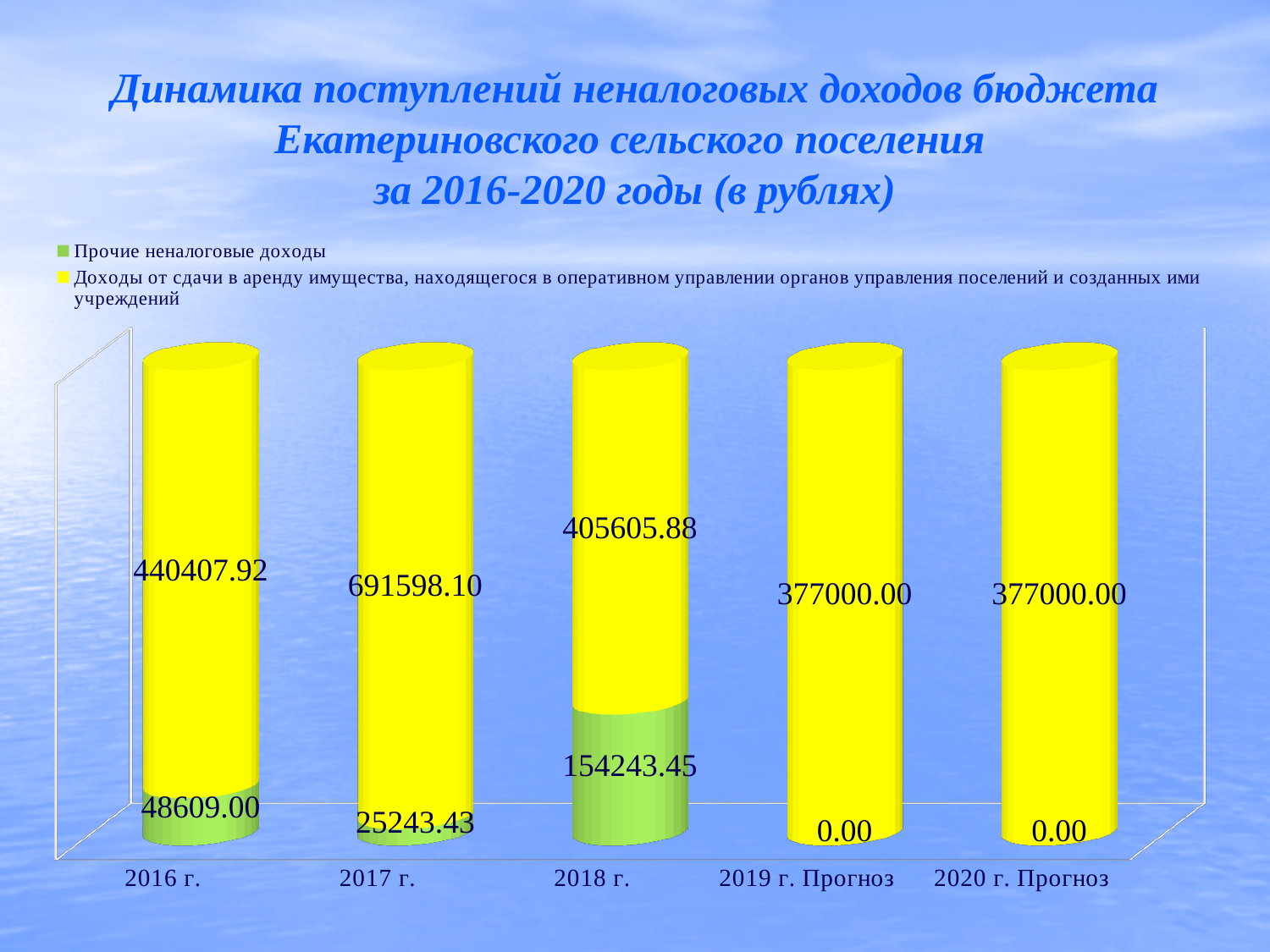
What is the value of «Прочие неналоговые доходы» for 2018 г.? 154243.45 What is the difference between the «Прочие неналоговые доходы» values for 2018 г. and 2016 г.? 105634.45 In which year is the value of «Прочие неналоговые доходы» the highest? 2018 г. What is the value of «Прочие неналоговые доходы» for 2019 г. Прогноз? 0.00 In which year is the value of «Доходы от сдачи в аренду имущества...» the highest? 2017 г. What is the value of «Доходы от сдачи в аренду имущества...» for 2017 г.? 691598.10 What is the difference between the «Доходы от сдачи в аренду имущества...» values for 2017 г. and 2016 г.? 251190.18 What is the total of the stacked bar for 2018 г.? 559849.33 Which is larger: the «Доходы от сдачи в аренду имущества...» value for 2016 г. or for 2018 г.? 2016 г. How many years (categories) are shown on the x axis? 5 What kind of chart is shown on the slide? Stacked bar chart How many series does the legend list? 2